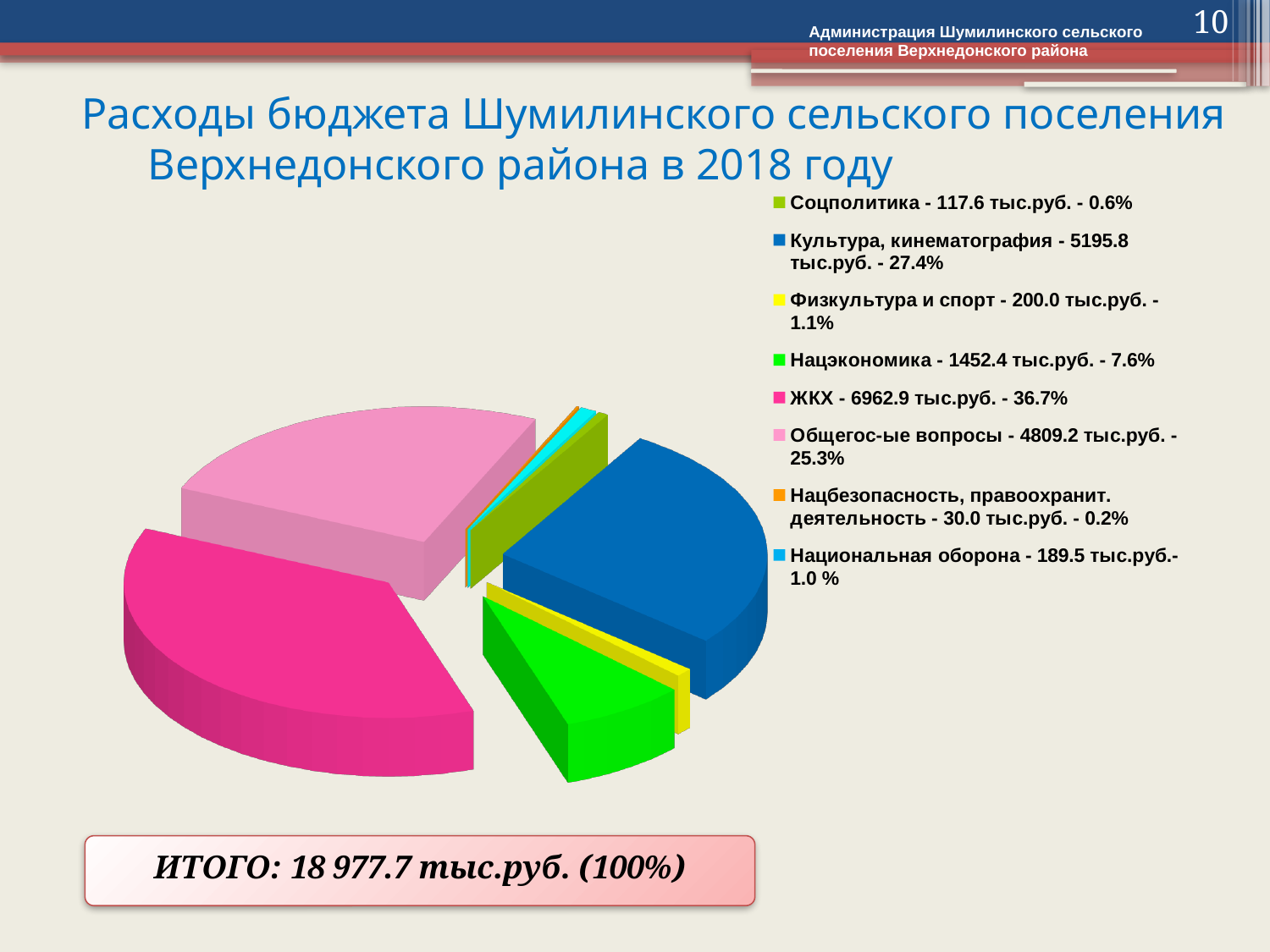
What is the value for Нацэкономика? 1452.4 тыс.руб. What share of the pie does Национальная оборона account for? 1.0 % Which is larger: Общегос-ые вопросы or Нацэкономика? Общегос-ые вопросы Which category has the smallest share of the pie? Нацбезопасность, правоохранит. деятельность Which category has the largest share of the pie? ЖКХ How many categories does the pie chart's legend list? 8 What is the total of all budget expenditures shown on the slide? 18 977.7 тыс.руб. What share of the pie does Культура, кинематография account for? 27.4% What kind of chart is shown on the slide? pie chart What colour represents ЖКХ in the pie chart? pink (magenta) What is the difference in value between ЖКХ and Культура, кинематография? 1767.1 тыс.руб. What is the value for ЖКХ according to the legend? 6962.9 тыс.руб.